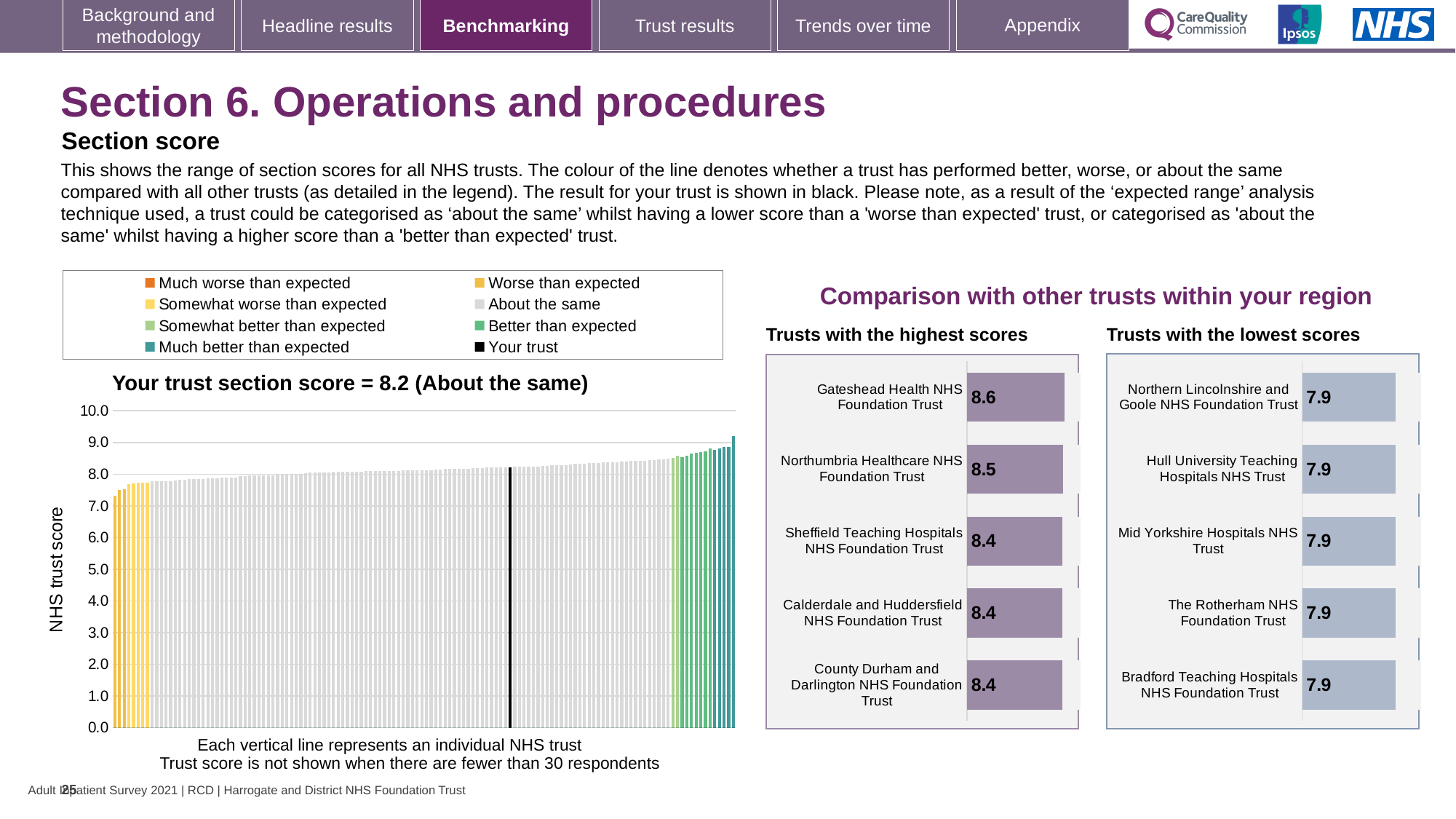
How many entries does the legend above the chart titled 'Your trust section score = 8.2 (About the same)' list? 8 In the chart 'Trusts with the highest scores', which trust has the highest score? Gateshead Health NHS Foundation Trust In the chart titled 'Your trust section score = 8.2 (About the same)', what is the section score for your trust? 8.2 In the chart 'Trusts with the highest scores', what is the score for Gateshead Health NHS Foundation Trust? 8.6 What kind of chart is the chart titled 'Your trust section score = 8.2 (About the same)'? bar chart In the chart titled 'Your trust section score = 8.2 (About the same)', do the bars rise or fall from left to right? rise What is the y-axis label of the chart titled 'Your trust section score = 8.2 (About the same)'? NHS trust score In the chart titled 'Your trust section score = 8.2 (About the same)', is the value of the rightmost bar greater or less than 8.0? greater How many trusts are shown in the chart 'Trusts with the lowest scores'? 5 In the chart 'Trusts with the lowest scores', what is the score for Mid Yorkshire Hospitals NHS Trust? 7.9 In the chart titled 'Your trust section score = 8.2 (About the same)', is the value of the leftmost bar greater or less than 8.0? less In the chart 'Trusts with the highest scores', what is the difference between the scores of Gateshead Health NHS Foundation Trust and Northumbria Healthcare NHS Foundation Trust? 0.1